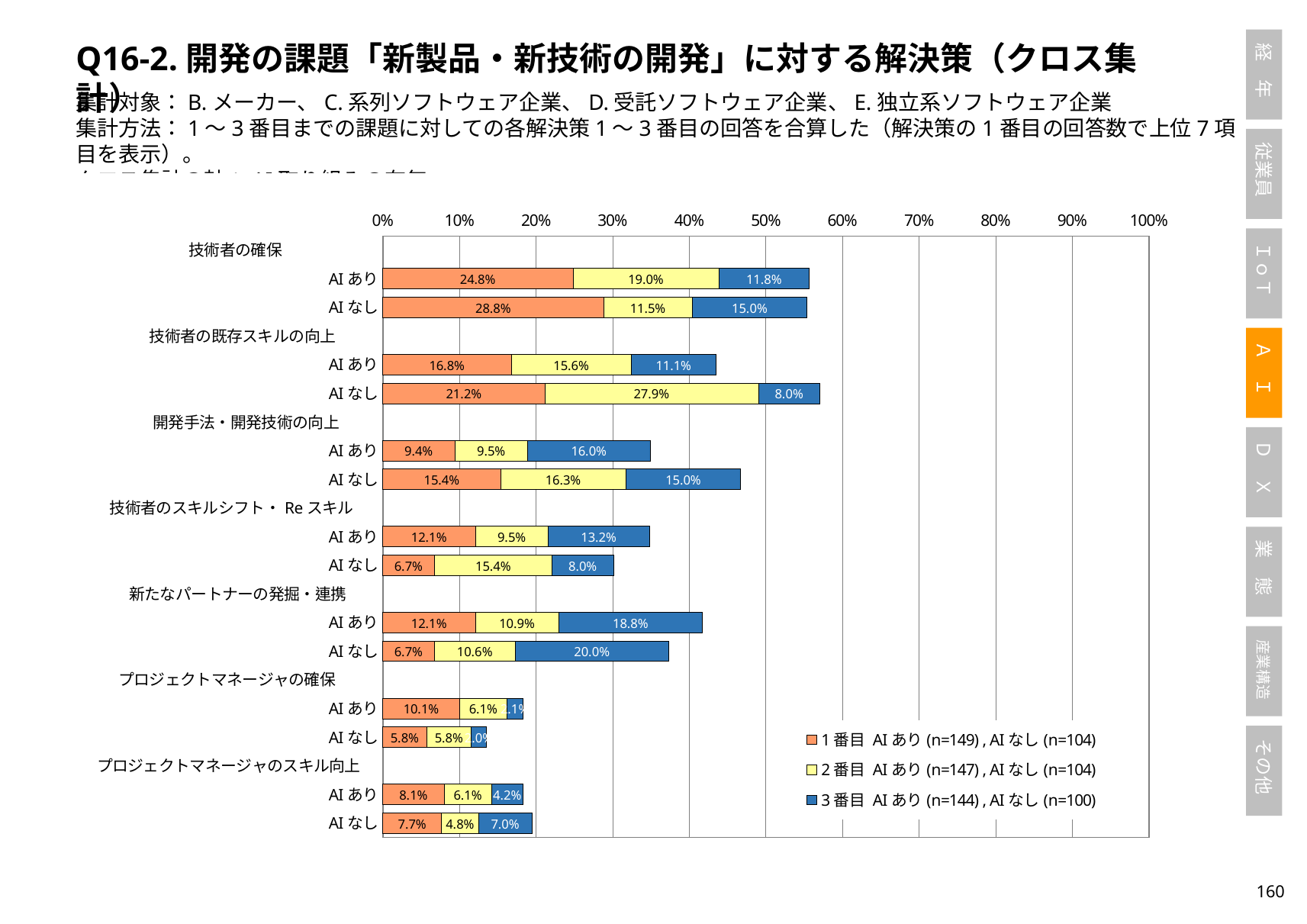
Is the total of the stacked bar for プロジェクトマネージャのスキル向上, AIなし greater or less than 30%? less What is the 1番目 value for 技術者の確保, AIあり? 24.8% How many series does the legend list? 3 What is the n for AIあり in the 1番目 series according to the legend? n=149 Which is larger: the 3番目 value for 開発手法・開発技術の向上 AIあり or the 3番目 value for 技術者のスキルシフト・Reスキル AIあり? 開発手法・開発技術の向上 AIあり (16.0%) What is the total of the stacked bar for 技術者の既存スキルの向上, AIなし? 57.1% What is the difference between the 1番目 values for 技術者の確保 AIなし and AIあり? 4.0% What kind of chart is shown on the slide? stacked bar chart How many solution categories (groups) are shown on the chart? 7 Which bar has the highest 1番目 value? 技術者の確保, AIなし (28.8%) What is the 2番目 value for 技術者の既存スキルの向上, AIなし? 27.9% What is the 3番目 value for 新たなパートナーの発掘・連携, AIなし? 20.0%